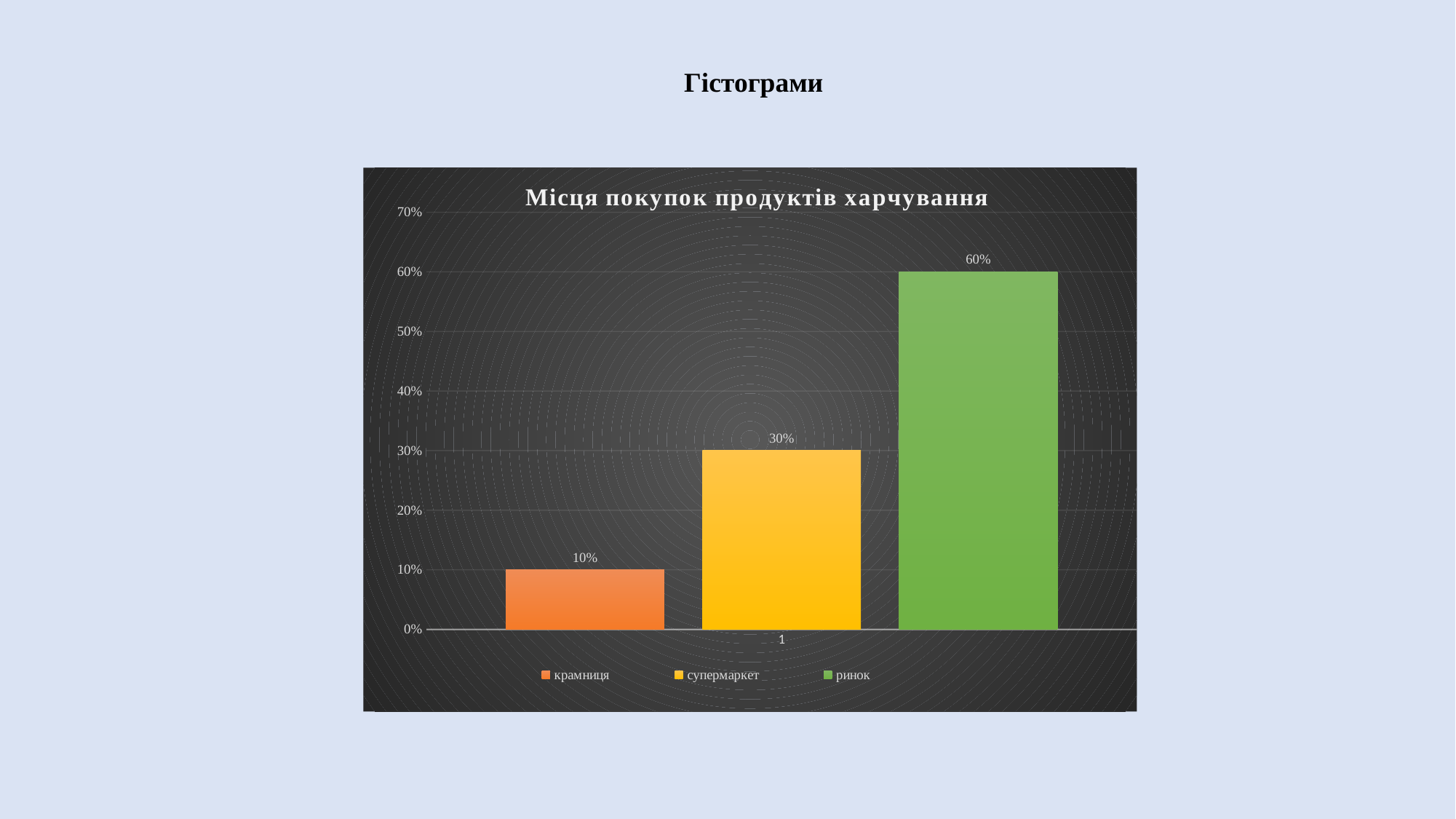
What kind of chart is shown on the slide? bar chart What is the title of the chart? Місця покупок продуктів харчування What is the value for ринок? 60% What is the value for крамниця? 10% What is the difference between the values for ринок and супермаркет? 30% What is the difference between the values for супермаркет and крамниця? 20% What is the value for супермаркет? 30% How many series does the legend list? 3 Which series has the highest value? ринок Which series has the lowest value? крамниця Is the value for ринок greater or less than 50%? greater Which is larger, the value for супермаркет or the value for крамниця? супермаркет